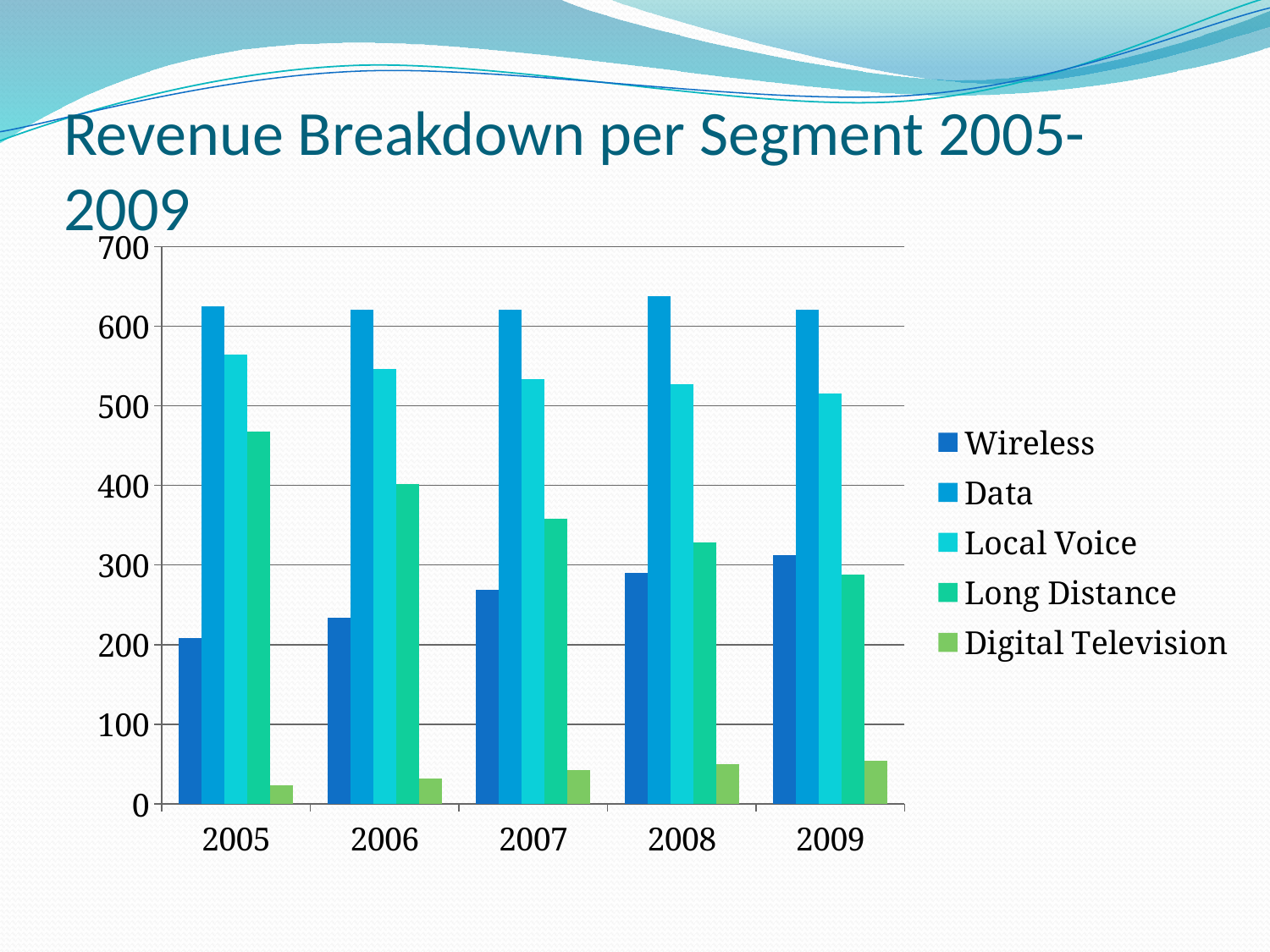
Does Wireless revenue rise or fall from 2005 to 2009? rise Which segment has the highest revenue in 2005? Data How many years are shown on the x axis? 5 What is the title of the chart? Revenue Breakdown per Segment 2005-2009 Does Long Distance revenue rise or fall from 2005 to 2009? fall Is the value for Digital Television in 2009 greater or less than 100? less Is the value for Long Distance in 2005 greater or less than 400? greater Which segment has the lowest revenue in 2009? Digital Television In 2005, which is larger: Local Voice or Long Distance? Local Voice What kind of chart is shown on the slide? bar chart Is the value for Wireless in 2005 greater or less than 300? less How many series does the legend list? 5